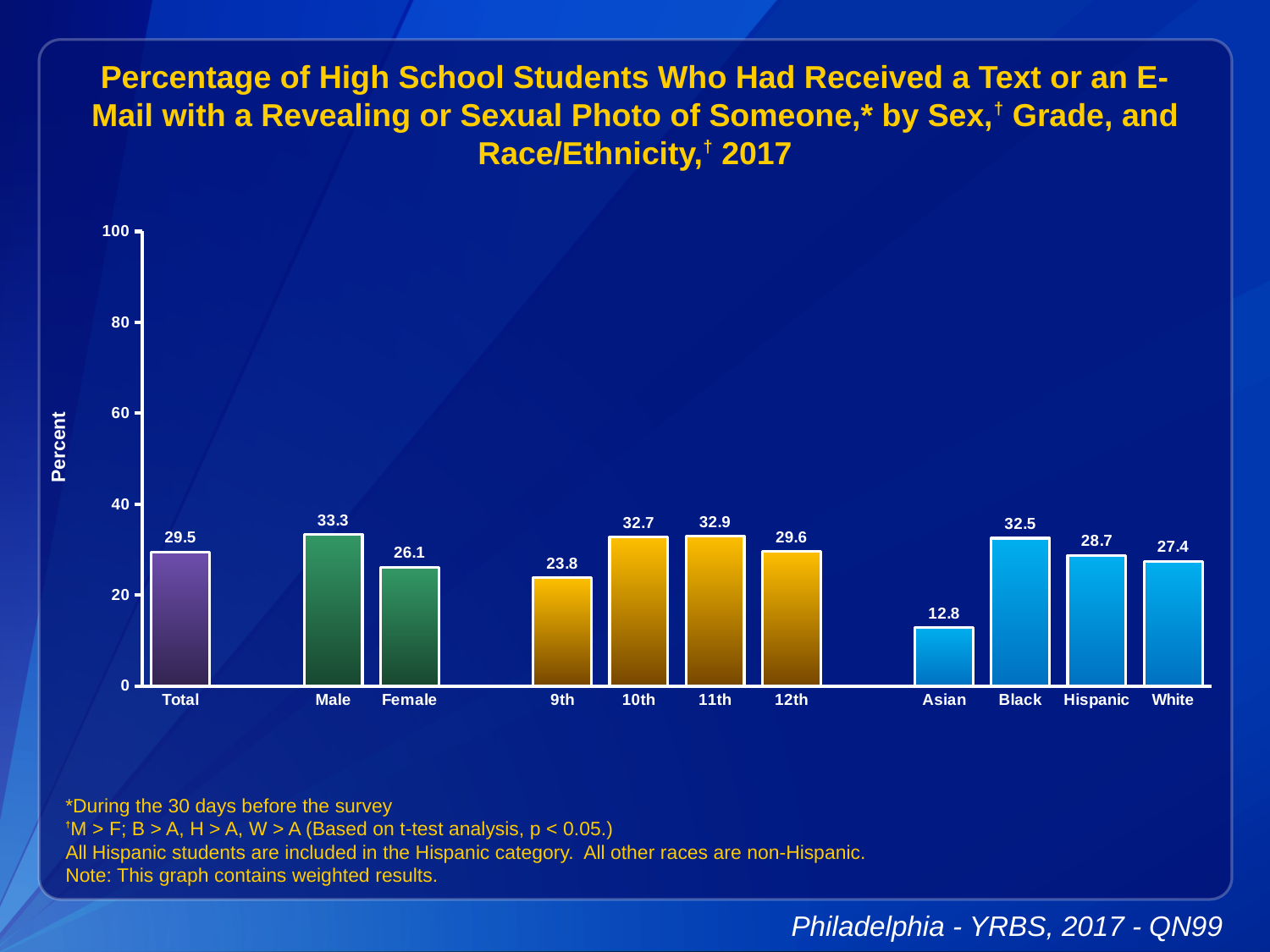
Do the values rise or fall from 9th grade to 10th grade? rise Which is larger, the value for Black or the value for White? Black Which category has the lowest value? Asian What is the label of the y axis? Percent What kind of chart is shown on the slide? bar chart Which category has the highest value? Male What is the difference between the Male and Female values? 7.2 What is the value for 11th grade? 32.9 Is the value for Asian greater or less than 20? less How many bars are shown in the chart? 11 What is the value for Total? 29.5 What is the value for Female? 26.1